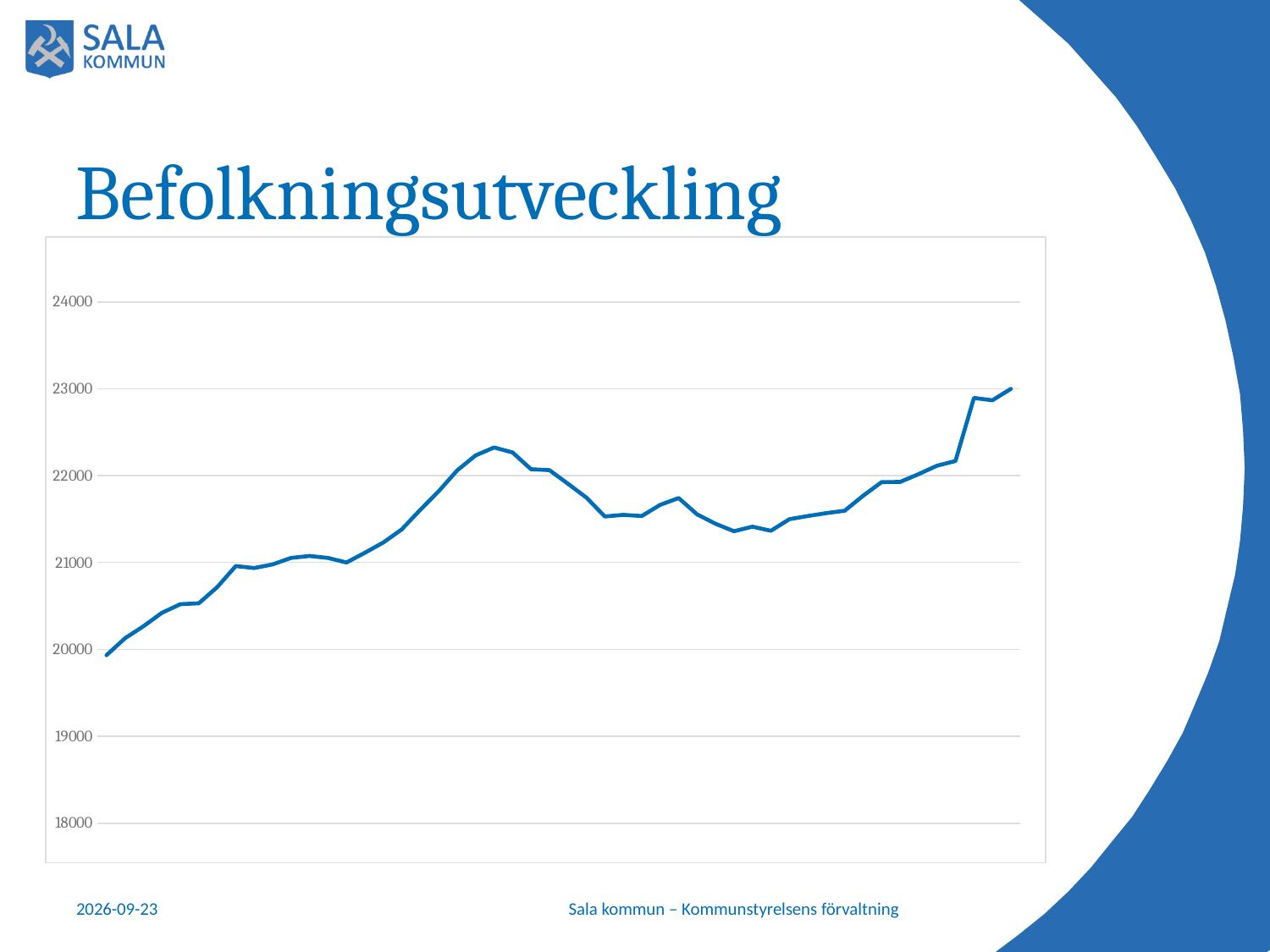
What kind of chart is shown on the slide? line chart Is the local peak in the middle of the chart greater or less than 22000? greater What is the lowest value shown on the vertical axis? 18000 Is the value at the right end of the line greater or less than 22000? greater Is the value at the left end of the line greater or less than 21000? less What is the title of the slide containing the chart? Befolkningsutveckling Does the line generally rise or fall from left to right? rise Is the value at the right end of the line higher or lower than the value at the left end? higher